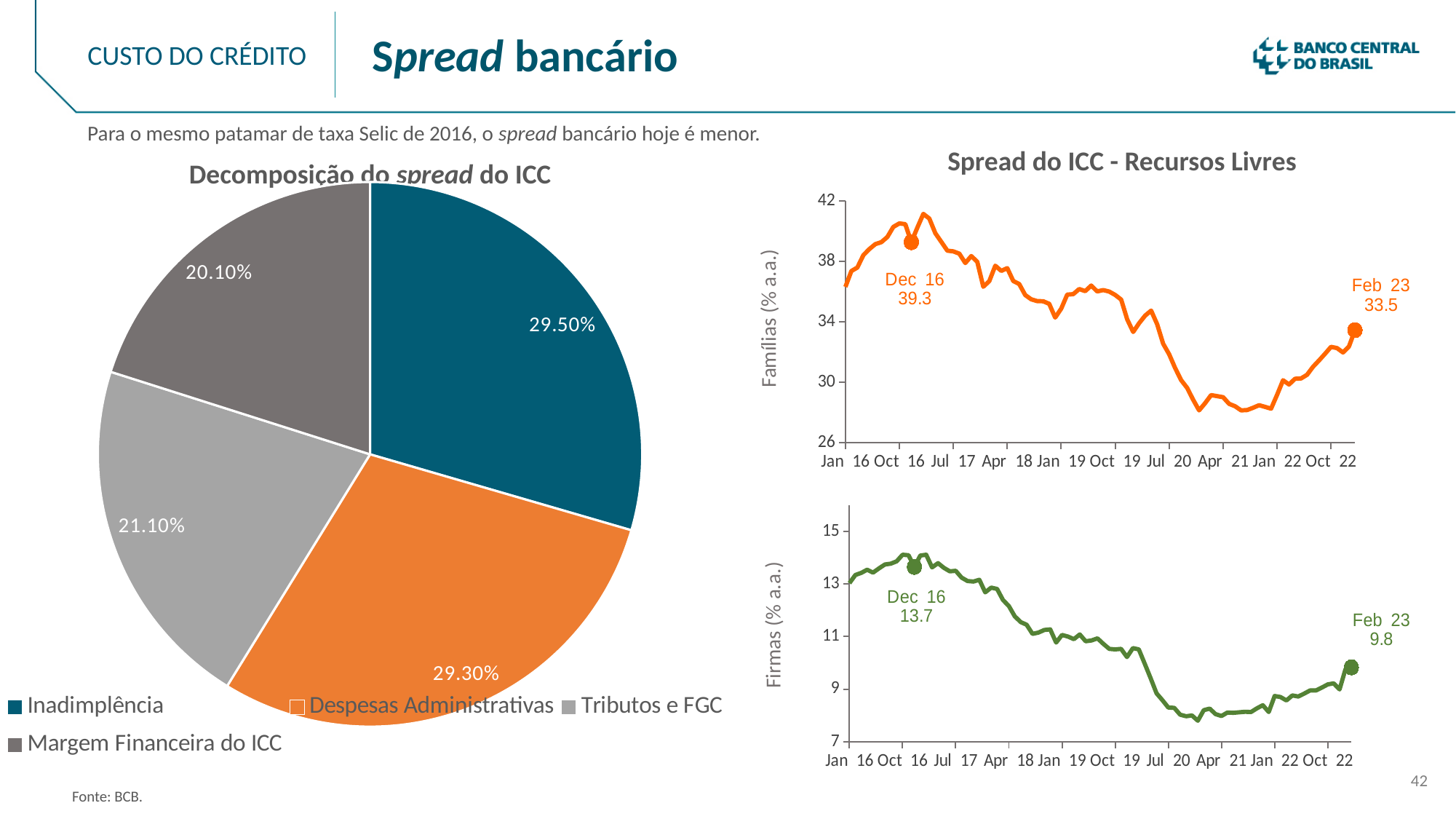
In the 'Spread do ICC - Recursos Livres' chart for Famílias, what value is labelled for Feb 23? 33.5 In the pie chart 'Decomposição do spread do ICC', which component has the smallest share? Margem Financeira do ICC In the pie chart 'Decomposição do spread do ICC', which component has the largest share? Inadimplência In the 'Spread do ICC - Recursos Livres' chart for Firmas, what value is labelled for Feb 23? 9.8 In the pie chart 'Decomposição do spread do ICC', what share is labelled for Tributos e FGC? 21.10% In the pie chart 'Decomposição do spread do ICC', what is the difference between the shares of Despesas Administrativas and Margem Financeira do ICC? 9.20% In the pie chart 'Decomposição do spread do ICC', how many components are shown? 4 In the 'Spread do ICC - Recursos Livres' chart for Firmas, by how much did the value fall from Dec 16 to Feb 23? 3.9 What type of chart is 'Spread do ICC - Recursos Livres' for Famílias? Line chart In the 'Spread do ICC - Recursos Livres' chart for Famílias, what value is labelled for Dec 16? 39.3 In the pie chart 'Decomposição do spread do ICC', what share is labelled for Inadimplência? 29.50%